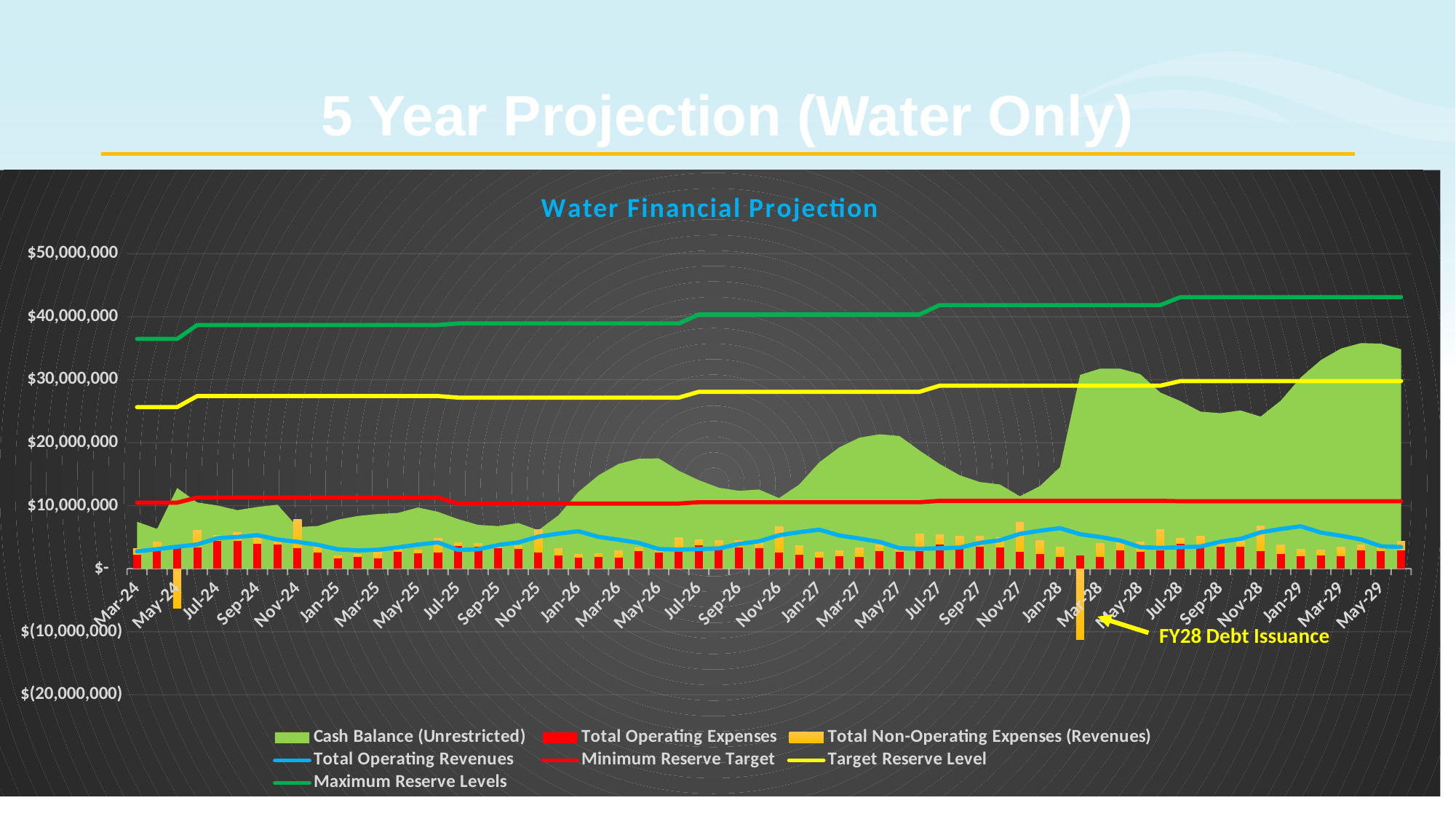
Which series has the highest values across the whole chart? Maximum Reserve Levels Is the Cash Balance (Unrestricted) value at May-29 greater or less than $30,000,000? greater At May-29, which is higher: Maximum Reserve Levels or Target Reserve Level? Maximum Reserve Levels Is the Minimum Reserve Target at Jan-26 greater or less than $20,000,000? less Is the Maximum Reserve Levels value at Mar-24 greater or less than $30,000,000? greater Does the Maximum Reserve Levels line rise or fall from Mar-24 to May-29? rise What is the title of the chart? Water Financial Projection How many series does the chart legend list? 7